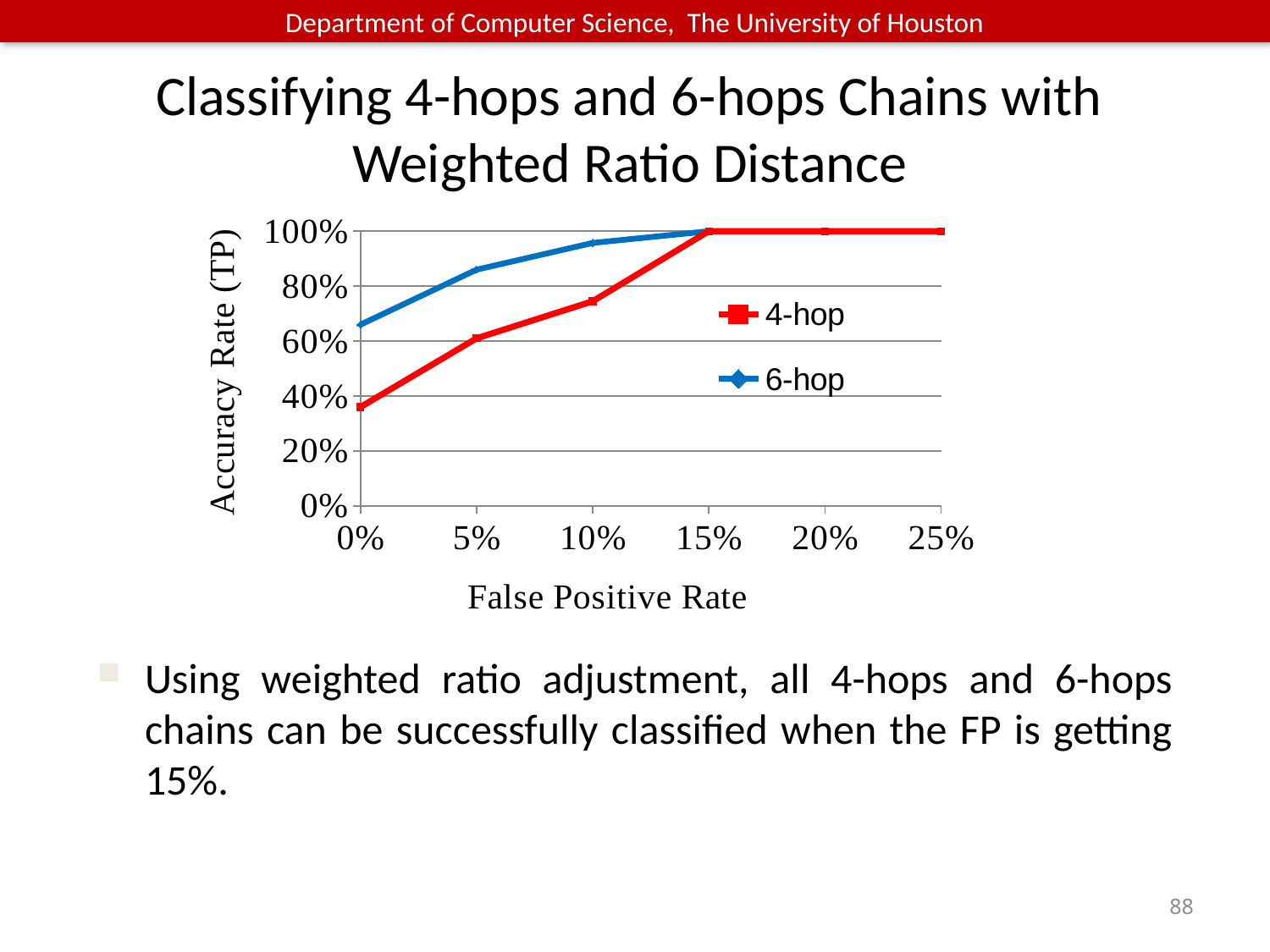
How many series does the legend list? 2 What are the two series named in the legend? 4-hop and 6-hop What is the label of the x axis? False Positive Rate What kind of chart is shown on the slide? line chart Is the Accuracy Rate for 4-hop at a False Positive Rate of 10% greater or less than 80%? less Is the Accuracy Rate for 4-hop at a False Positive Rate of 0% greater or less than 40%? less How many False Positive Rate values are marked on the x axis? 6 Does the Accuracy Rate for 4-hop rise or fall as the False Positive Rate increases from 0% to 15%? rise Is the Accuracy Rate for 6-hop at a False Positive Rate of 0% greater or less than 60%? greater What is the Accuracy Rate (TP) for 6-hop at a False Positive Rate of 25%? 100% What is the Accuracy Rate (TP) for 4-hop at a False Positive Rate of 15%? 100% Which series has the higher Accuracy Rate at a False Positive Rate of 5%, 4-hop or 6-hop? 6-hop